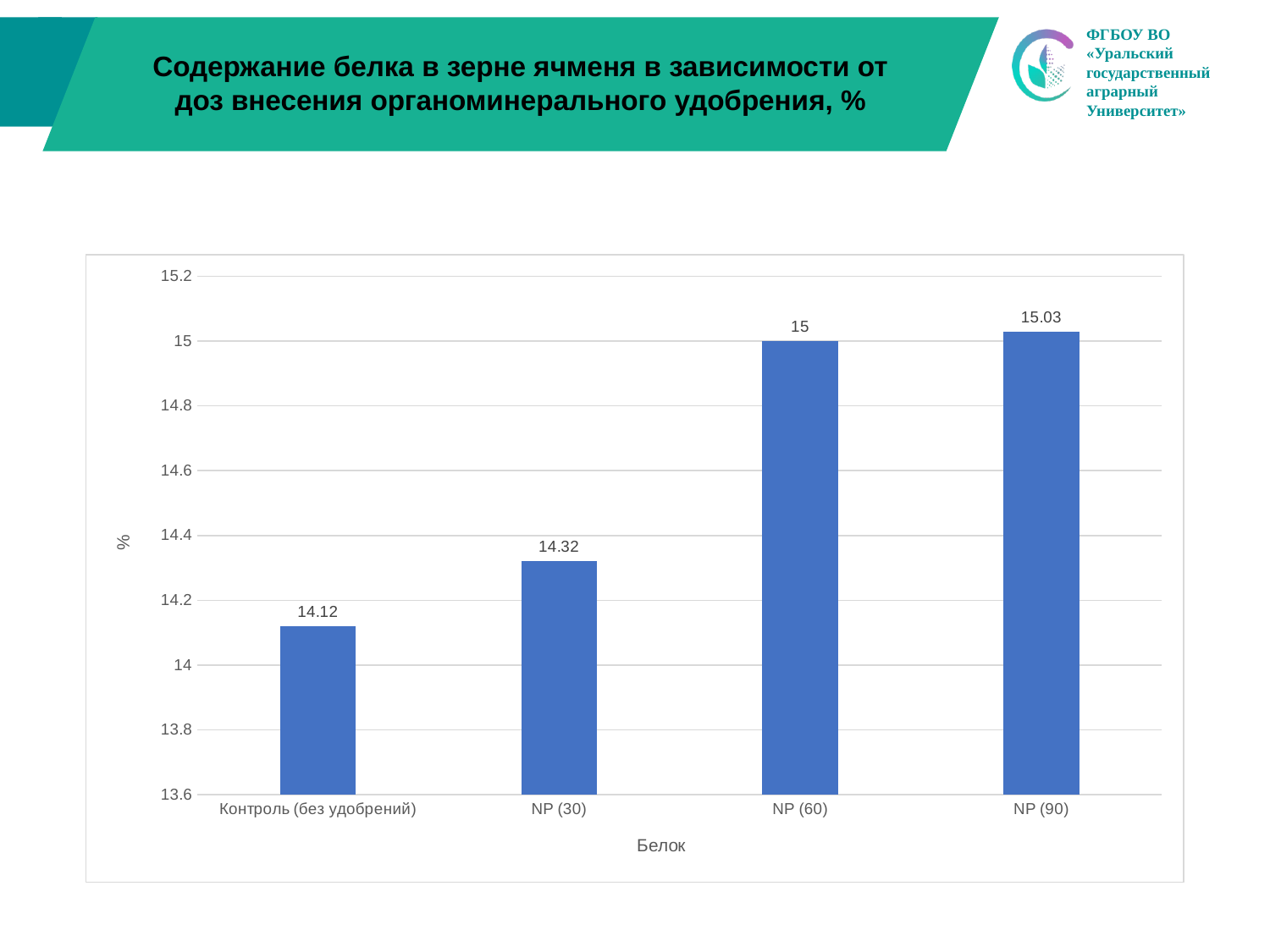
What is the difference between the values for NP (30) and Контроль (без удобрений)? 0.2 Which is larger, the value for NP (30) or the value for NP (60)? NP (60) How many categories are shown on the x axis? 4 Do the values rise or fall from Контроль (без удобрений) to NP (90)? rise What is the value for NP (30)? 14.32 What is the difference between the values for NP (60) and NP (30)? 0.68 Which category has the lowest value? Контроль (без удобрений) What is the value for NP (90)? 15.03 What is the value for NP (60)? 15 What is the value for Контроль (без удобрений)? 14.12 What kind of chart is shown on the slide? bar chart Which category has the highest value? NP (90)